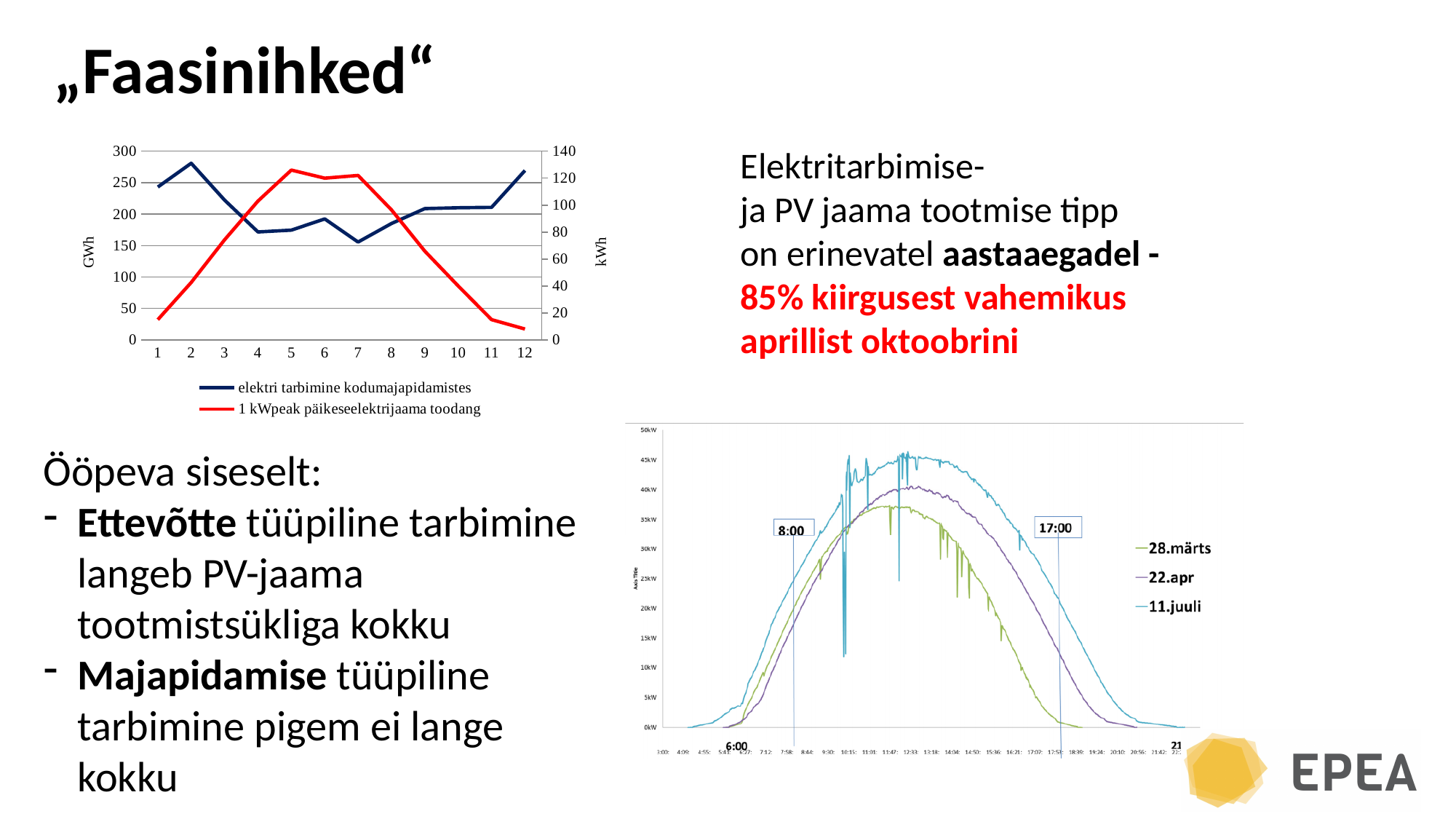
What kind of chart is the top-left chart with the GWh and kWh axes? line chart In the top-left chart, how many months are plotted along the x axis? 12 In the bottom-right chart, how many series does the legend list? 3 In the top-left chart, how many series does the legend list? 2 In the top-left chart, is the value for 'elektri tarbimine kodumajapidamistes' in month 2 greater or less than 250 GWh? greater In the top-left chart, in which month is '1 kWpeak päikeseelektrijaama toodang' highest? 5 In the top-left chart, in which month is 'elektri tarbimine kodumajapidamistes' lowest? 7 In the top-left chart, is the value for '1 kWpeak päikeseelektrijaama toodang' in month 12 greater or less than 20 kWh? less In the bottom-right chart, which date has the highest peak output? 11.juuli In the bottom-right chart, is the peak value for 28.märts greater or less than 40kW? less In the top-left chart, in which month is 'elektri tarbimine kodumajapidamistes' highest? 2 In the top-left chart, does '1 kWpeak päikeseelektrijaama toodang' rise or fall from month 5 to month 12? fall